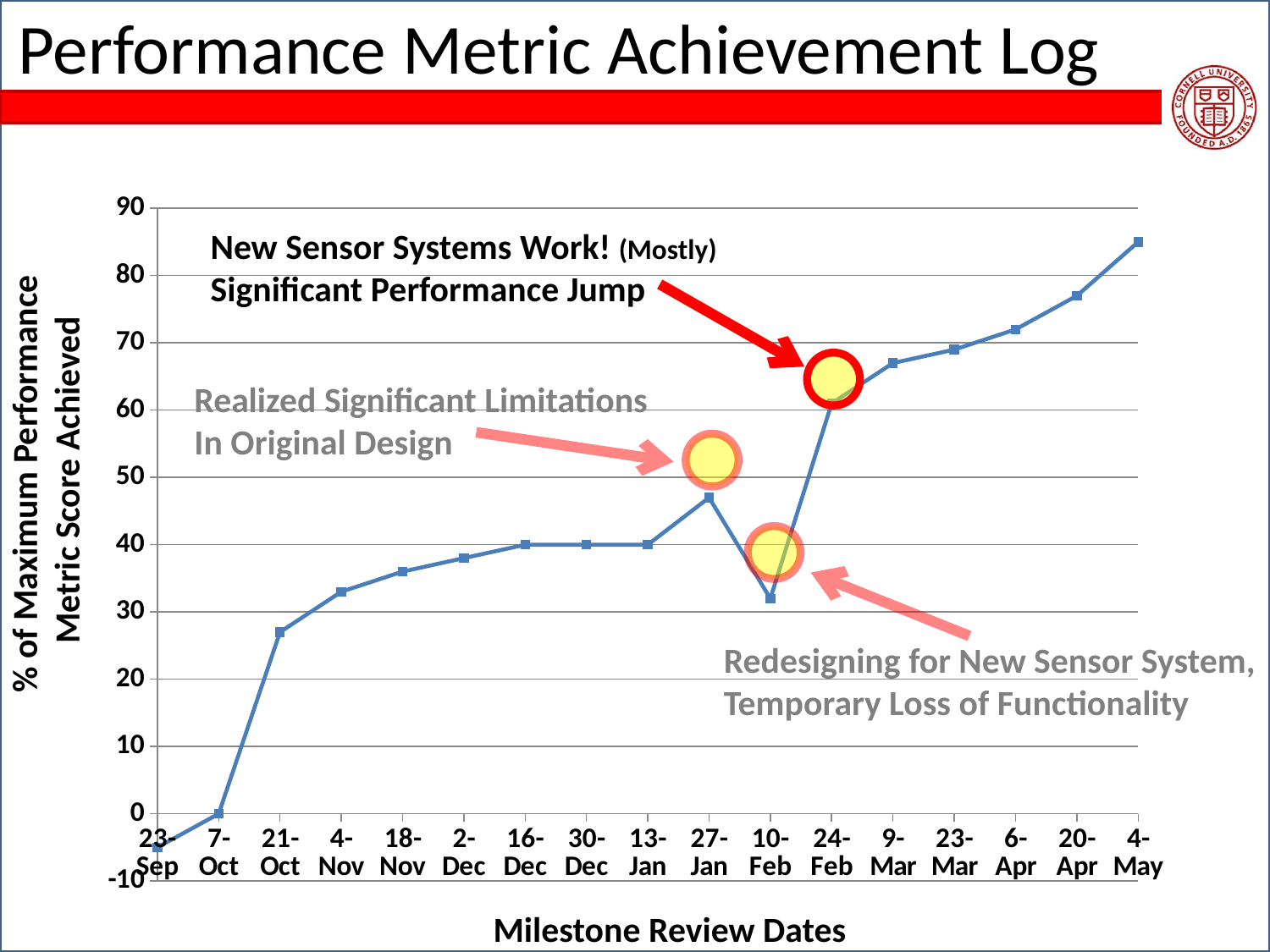
What is the title of the x axis? Milestone Review Dates Is the value for 4-May greater or less than 80? greater Which is larger, the value for 27-Jan or the value for 10-Feb? 27-Jan How many milestone review dates are plotted on the x axis? 17 Is the value for 21-Oct greater or less than 30? less Which milestone review date has the highest performance metric score? 4-May What is the title of the y axis? % of Maximum Performance Metric Score Achieved Do the values generally rise or fall from 23-Sep to 4-May? rise What kind of chart is shown on the slide? line chart Which milestone review date has the lowest performance metric score? 23-Sep Is the value for 10-Feb greater or less than 40? less